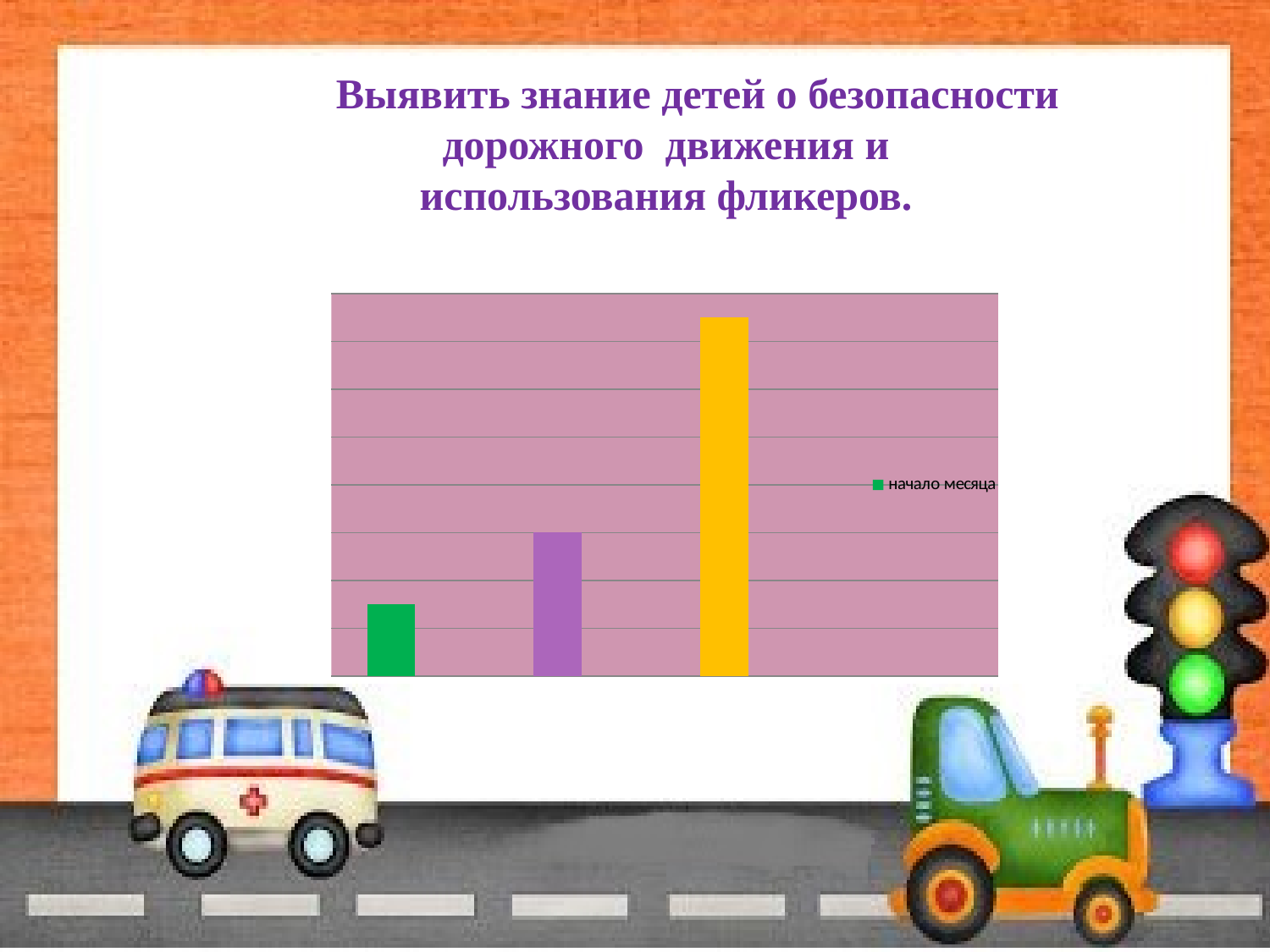
Which bar is the tallest in the chart: the green, the purple or the yellow one? the yellow one What is the legend entry shown next to the chart? начало месяца What kind of chart is shown on the slide? bar chart Is the green bar taller or shorter than the purple bar? shorter Which bar is the shortest in the chart: the green, the purple or the yellow one? the green one Do the bar heights rise or fall from left to right across the chart? rise What colour is the bar on the far left of the chart? green How many bars are plotted in the chart? 3 Is the purple bar taller or shorter than the yellow bar? shorter How many series does the chart legend list? 1